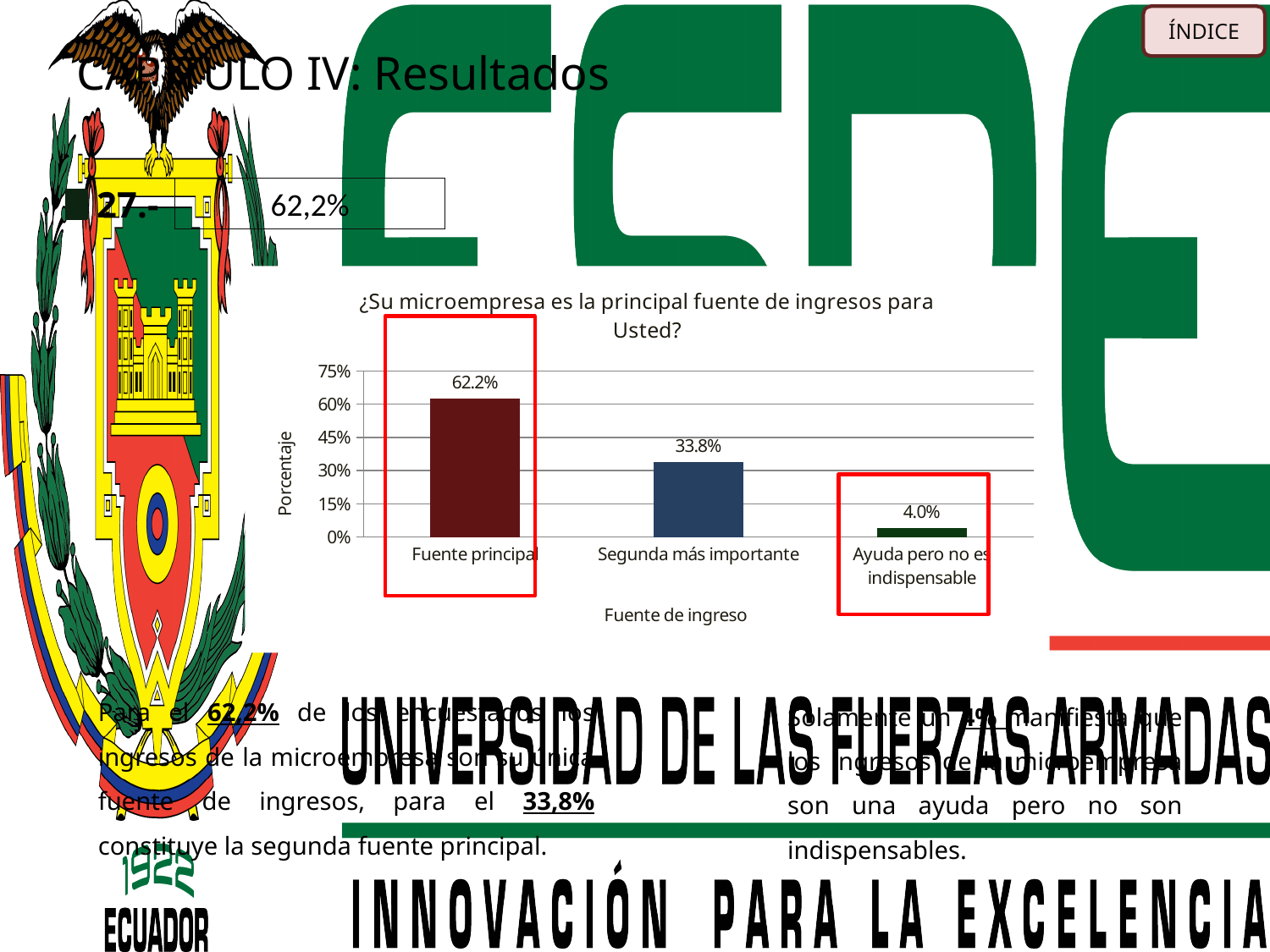
Which category has the lowest value? Ayuda pero no es indispensable What is the label of the y axis? Porcentaje Which category has the highest value? Fuente principal Which is larger, the value for Segunda más importante or the value for Ayuda pero no es indispensable? Segunda más importante What is the value for Segunda más importante? 33.8% What is the value for Ayuda pero no es indispensable? 4.0% Do the values rise or fall from left to right along the x axis? fall Is the value for Segunda más importante greater or less than 45%? less What kind of chart is shown on the slide? bar chart What is the difference between the values for Fuente principal and Segunda más importante? 28.4% How many categories are shown on the x axis? 3 What is the value for Fuente principal? 62.2%